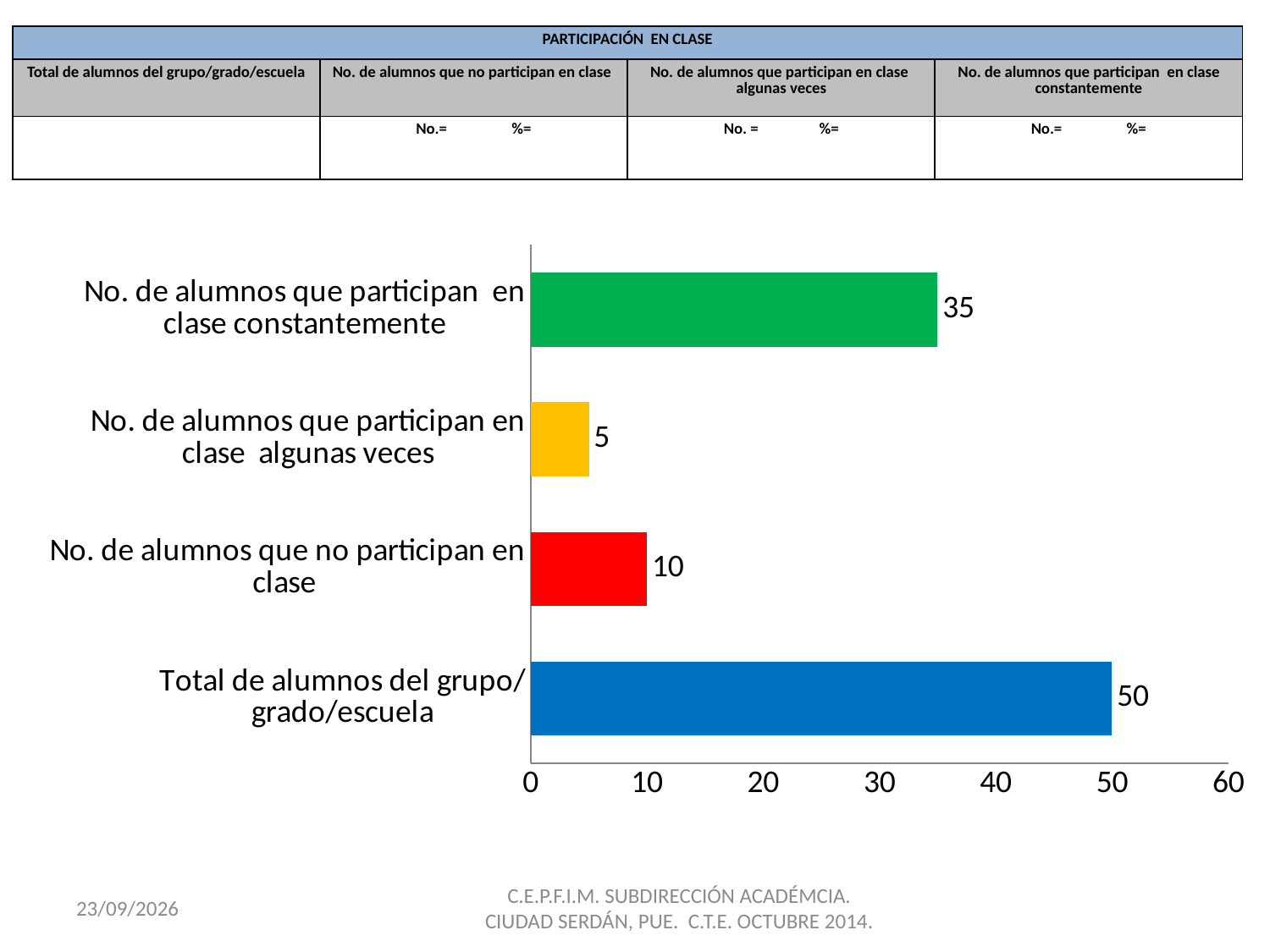
What is the value for 'No. de alumnos que no participan en clase'? 10 Which is larger: the value for 'No. de alumnos que no participan en clase' or the value for 'No. de alumnos que participan en clase algunas veces'? No. de alumnos que no participan en clase What kind of chart is shown on the slide? Bar chart How many categories are shown in the chart? 4 What is the difference between the value for 'Total de alumnos del grupo/grado/escuela' and the value for 'No. de alumnos que participan en clase constantemente'? 15 What is the value for 'No. de alumnos que participan en clase algunas veces'? 5 Which category has the highest value? Total de alumnos del grupo/grado/escuela What is the difference between the value for 'No. de alumnos que no participan en clase' and the value for 'No. de alumnos que participan en clase algunas veces'? 5 What colour is the bar for 'No. de alumnos que no participan en clase'? Red What is the value for 'No. de alumnos que participan en clase constantemente'? 35 What is the value for 'Total de alumnos del grupo/grado/escuela'? 50 Which category has the lowest value? No. de alumnos que participan en clase algunas veces